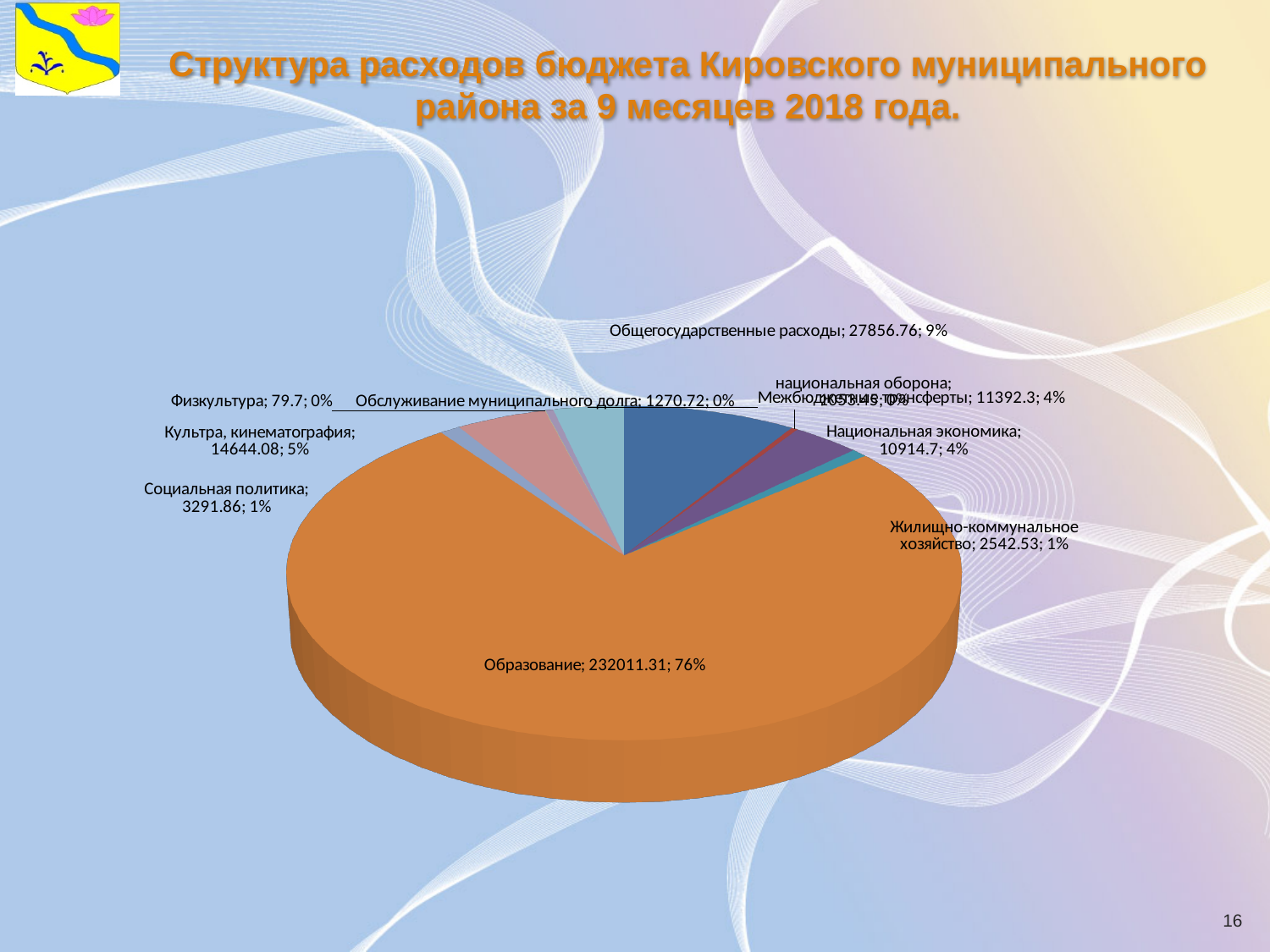
What share of the pie does Общегосударственные расходы represent? 9% What is the value shown for Межбюджетные трансферты? 11392.3 Which category has the largest slice of the pie? Образование What share of the pie does Образование represent? 76% Which is larger, the value for Межбюджетные трансферты or the value for Национальная экономика? Межбюджетные трансферты What is the value shown for Культра, кинематография? 14644.08 What is the value shown for Общегосударственные расходы? 27856.76 What is the difference between the values for Социальная политика and Жилищно-коммунальное хозяйство? 749.33 What kind of chart is shown on the slide? pie chart How many categories are shown in the pie chart? 10 What is the value shown for Образование? 232011.31 Which category has the smallest value in the pie chart? Физкультура